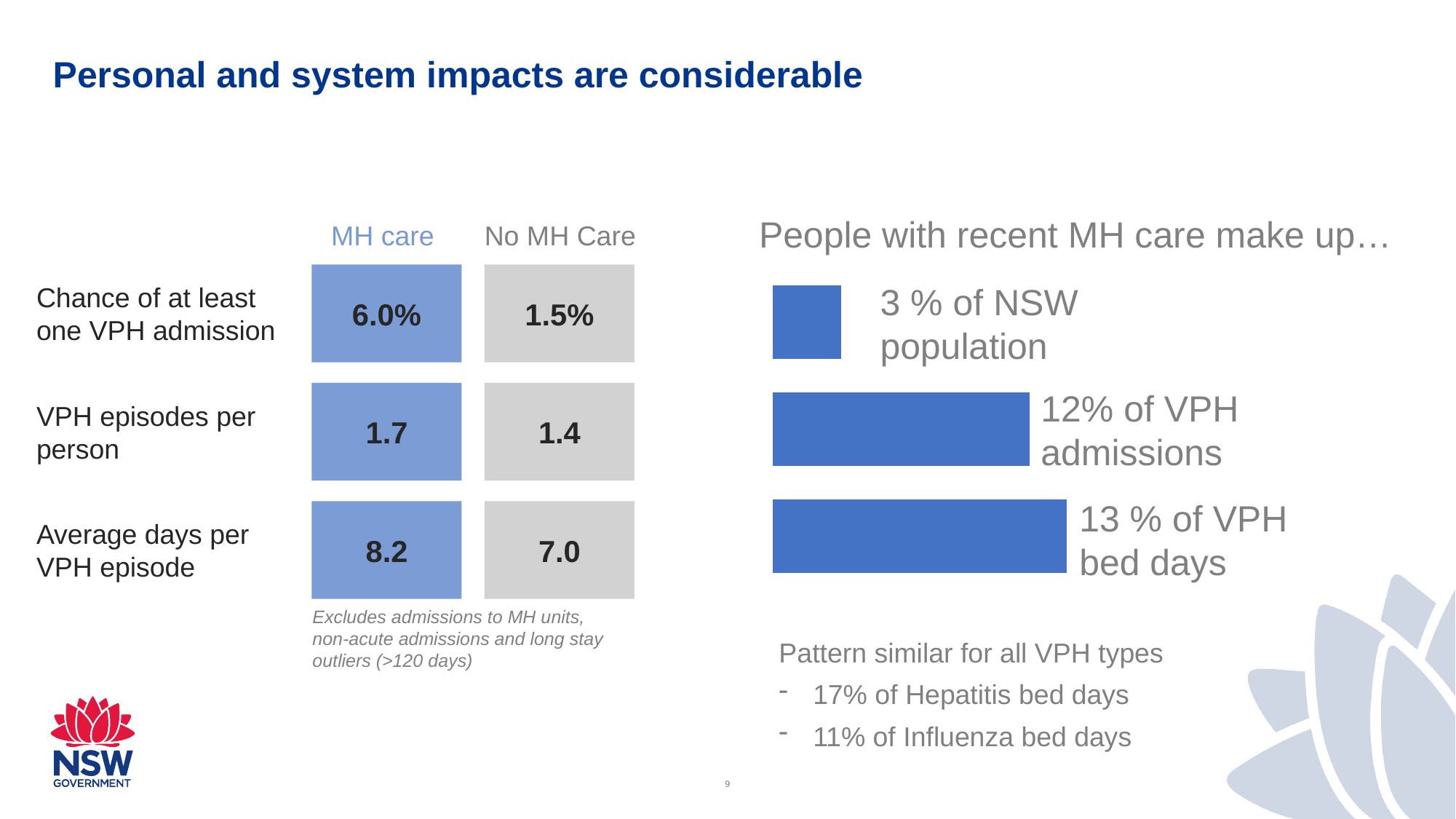
On the right-hand chart, which category has the shortest bar? NSW population On the right-hand chart, what share of VPH admissions do people with recent MH care make up? 12% On the right-hand chart, which is larger: the share of VPH admissions or the share of NSW population? VPH admissions On the right-hand chart, what share of VPH bed days do people with recent MH care make up? 13 % On the right-hand chart, which category has the longest bar? VPH bed days How many bars are shown on the right-hand chart? 3 On the right-hand chart titled 'People with recent MH care make up…', what share of the NSW population do people with recent MH care make up? 3 % On the right-hand chart, what is the difference between the VPH bed days share and the NSW population share? 10% In the left-hand grid, what is the chance of at least one VPH admission for the MH care group? 6.0% What kind of chart is the right-hand chart? Bar chart What is the title of the right-hand chart? People with recent MH care make up… In the left-hand grid, what is the average days per VPH episode for the No MH Care group? 7.0